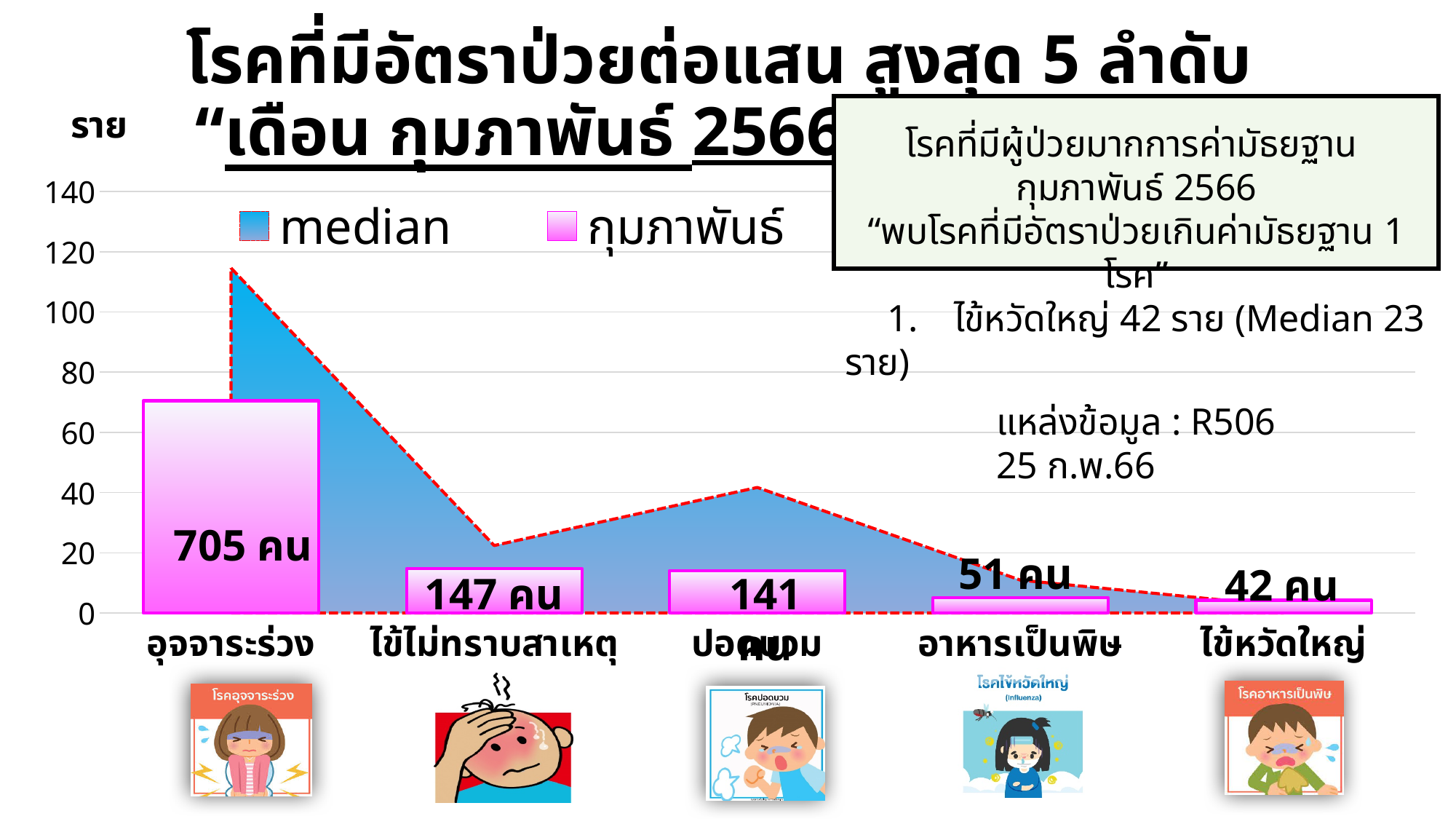
What is the data label shown for ไข้หวัดใหญ่? 42 คน How many series does the legend list? 2 For ปอดบวม, which is larger: the median area or the กุมภาพันธ์ bar? median What is the difference between the labelled values for อุจจาระร่วง and ไข้ไม่ทราบสาเหตุ? 558 คน What is the data label shown for อาหารเป็นพิษ? 51 คน Which category has the lowest labelled value? ไข้หวัดใหญ่ What is the data label shown for ไข้ไม่ทราบสาเหตุ? 147 คน Is the กุมภาพันธ์ bar for อุจจาระร่วง greater or less than 60 on the axis? greater Which category has the highest labelled value? อุจจาระร่วง What is the data label shown for อุจจาระร่วง? 705 คน Is the median value for อุจจาระร่วง greater or less than 100 on the axis? greater How many disease categories are shown on the x axis? 5